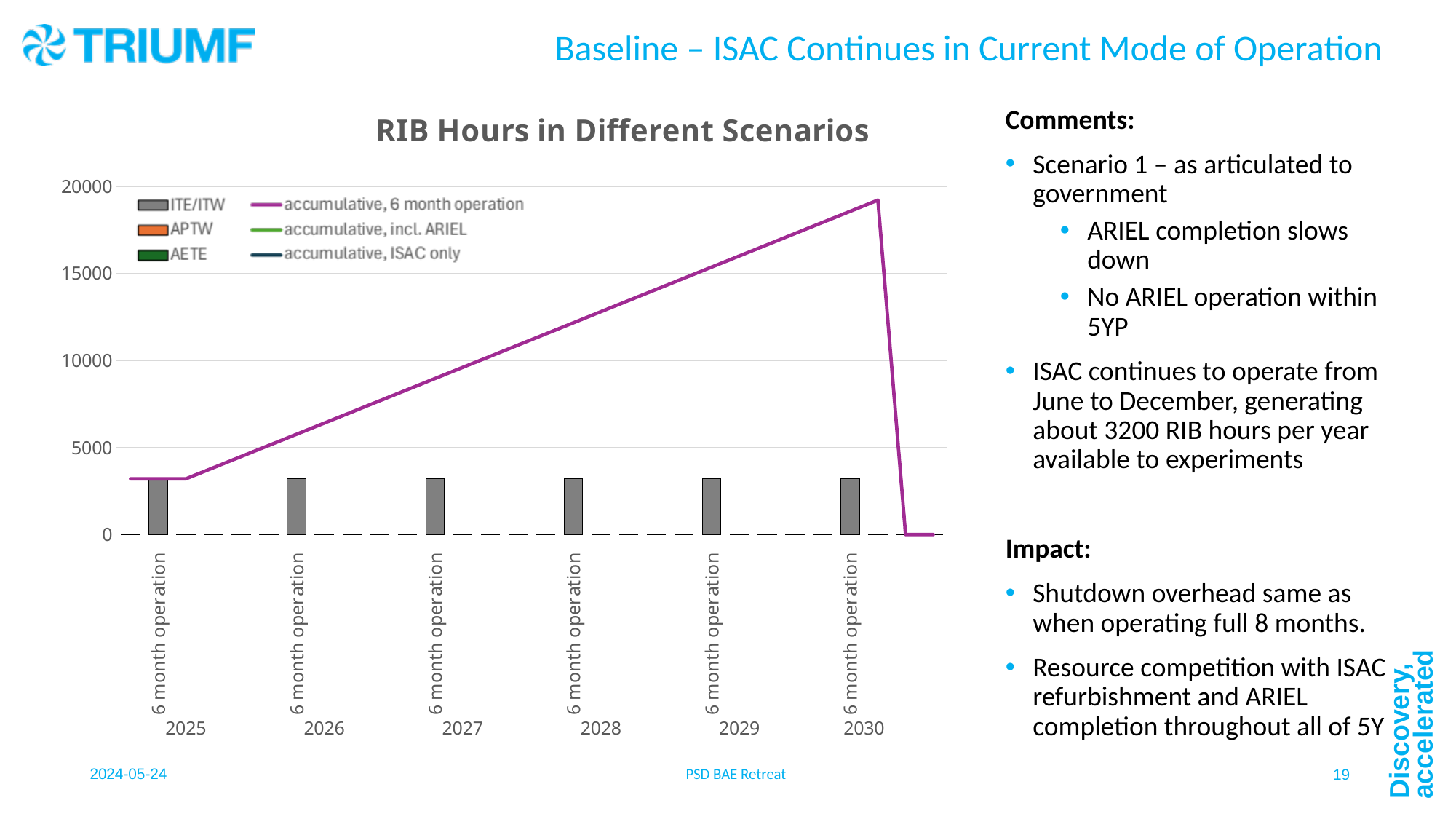
Is the ITE/ITW bar for 2025 greater or less than 5000? less Is the 'accumulative, 6 month operation' line at 2028 greater or less than 10000? greater What label appears under each bar on the x axis? 6 month operation What is the title of the chart? RIB Hours in Different Scenarios What colour are the ITE/ITW bars in the chart? Gray How many years are shown along the x axis of the chart? 6 Is the peak of the 'accumulative, 6 month operation' line greater or less than 15000? greater How many series does the chart legend list? 6 In which year does the 'accumulative, 6 month operation' line reach its highest value? 2030 Does the 'accumulative, 6 month operation' line rise or fall from 2025 to 2030? rise What kind of chart is shown on the slide? Combined bar and line chart